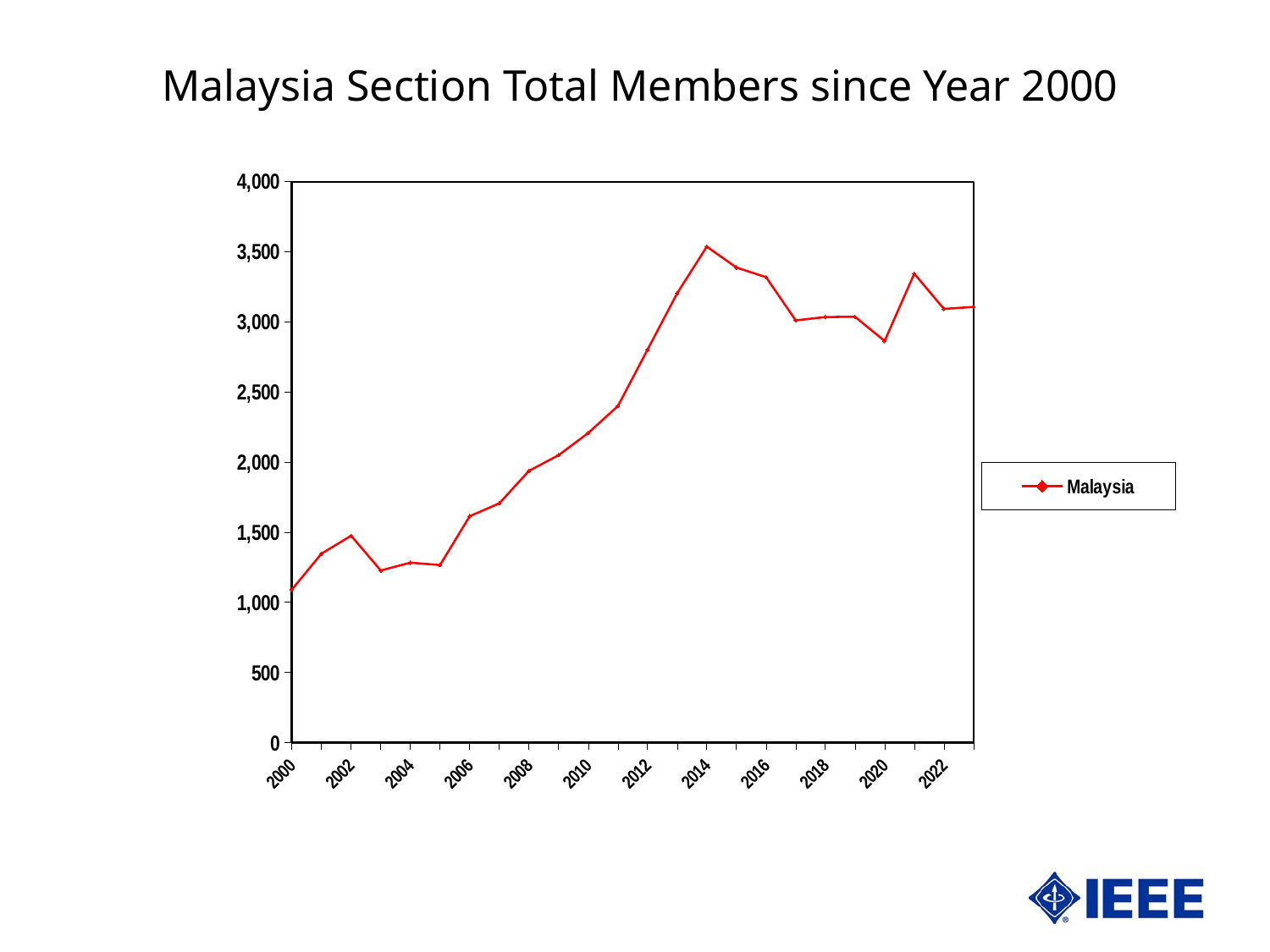
What is the title of the chart? Malaysia Section Total Members since Year 2000 In which year does the Malaysia line have its lowest value? 2000 What is the name of the series shown in the legend? Malaysia How many series does the legend list? 1 What kind of chart is shown on the slide? line chart Is the value for 2000 greater or less than 1,500? less Is the value for 2010 greater or less than 2,000? greater Which year has the larger value, 2012 or 2020? 2020 Is the value for 2014 greater or less than 3,500? greater Do the values generally rise or fall from 2000 to 2014? rise In which year does the Malaysia line reach its highest value? 2014